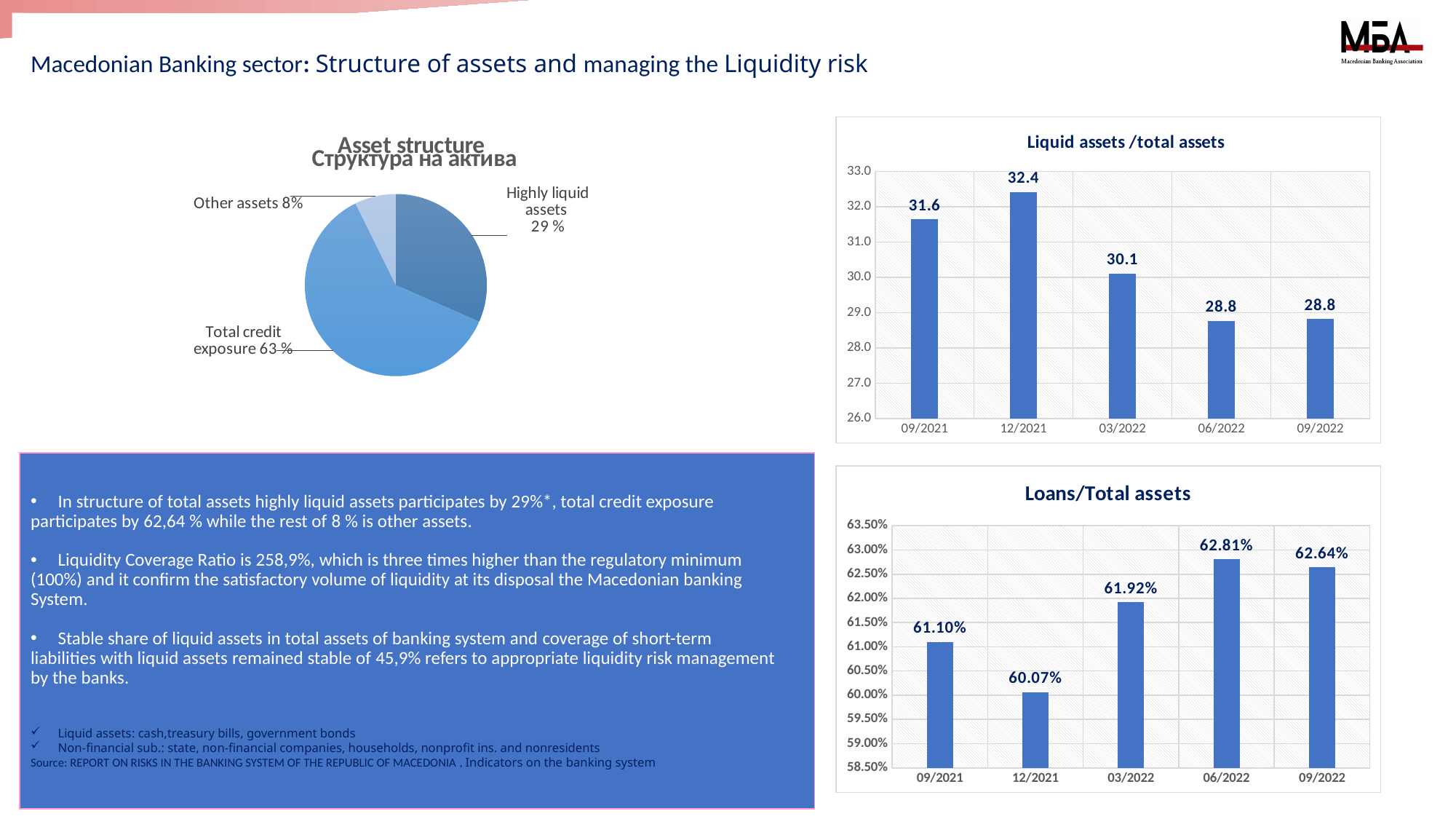
In the 'Loans/Total assets' chart, which is larger, the value for 09/2021 or the value for 03/2022? 03/2022 In the 'Liquid assets /total assets' chart, is the value for 06/2022 greater or less than 29.0? less In the 'Liquid assets /total assets' chart, how many periods are shown on the x axis? 5 In the 'Asset structure' pie chart, what share is labelled for Total credit exposure? 63 % What kind of chart is the 'Loans/Total assets' chart? bar chart In the 'Asset structure' pie chart, which slice is the smallest? Other assets In the 'Loans/Total assets' chart, what is the value for 06/2022? 62.81% In the 'Loans/Total assets' chart, what is the difference between the values for 06/2022 and 09/2022? 0.17% In the 'Liquid assets /total assets' chart, what is the difference between the values for 12/2021 and 03/2022? 2.3 In the 'Liquid assets /total assets' chart, what is the value for 12/2021? 32.4 In the 'Liquid assets /total assets' chart, which period has the highest value? 12/2021 In the 'Loans/Total assets' chart, which period has the lowest value? 12/2021